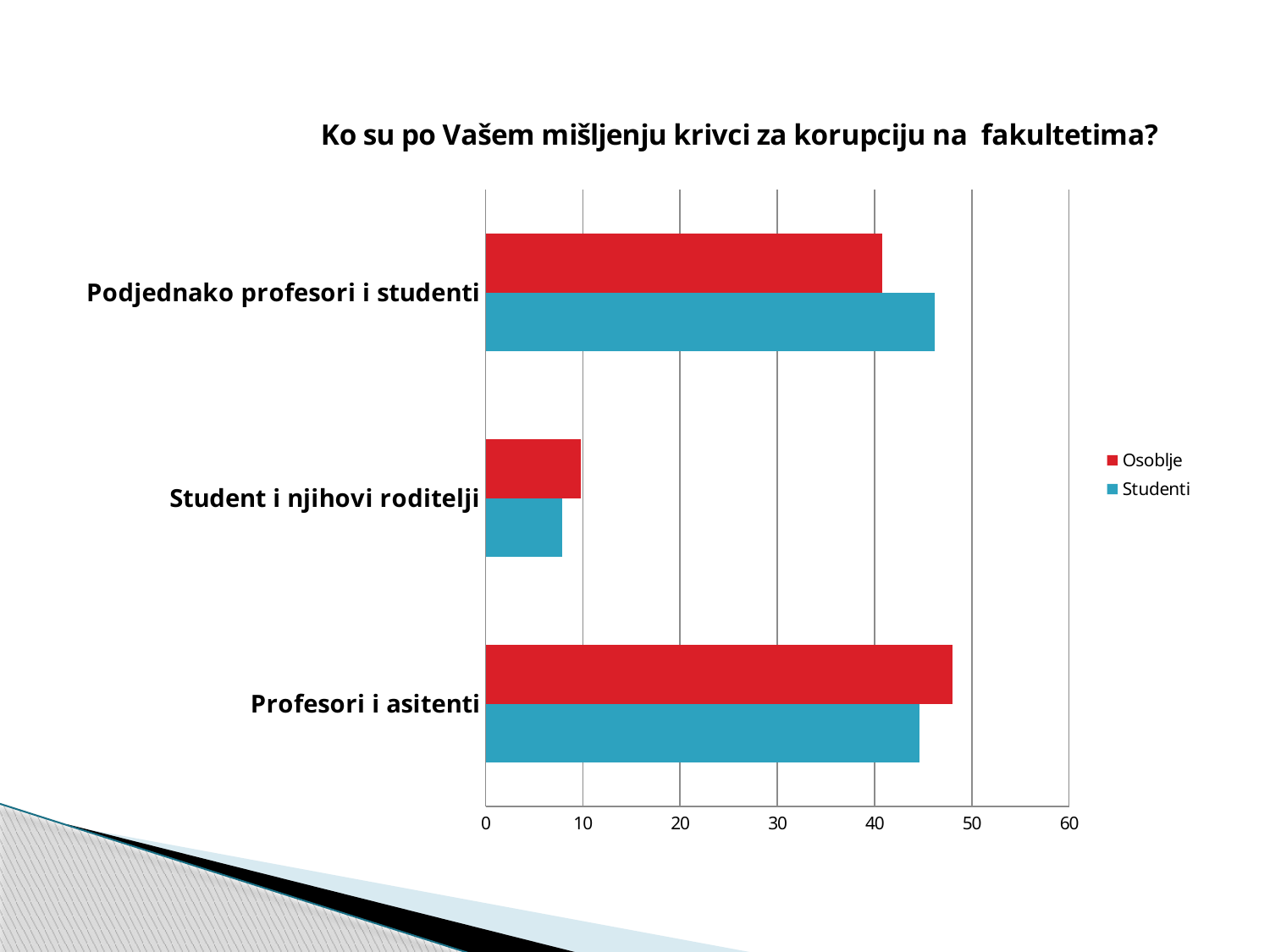
Is the Studenti value for Profesori i asitenti greater or less than 50? less For Podjednako profesori i studenti, which series has the larger value, Osoblje or Studenti? Studenti For the Osoblje series, which category has the highest value? Profesori i asitenti How many series does the legend list? 2 For Profesori i asitenti, which series has the larger value, Osoblje or Studenti? Osoblje What is the title of the chart? Ko su po Vašem mišljenju krivci za korupciju na fakultetima? How many categories are shown on the chart? 3 For the Studenti series, which category has the lowest value? Student i njihovi roditelji What kind of chart is shown on the slide? bar chart Which series is shown in red? Osoblje Is the Studenti value for Podjednako profesori i studenti greater or less than 40? greater Is the Osoblje value for Student i njihovi roditelji greater or less than 20? less